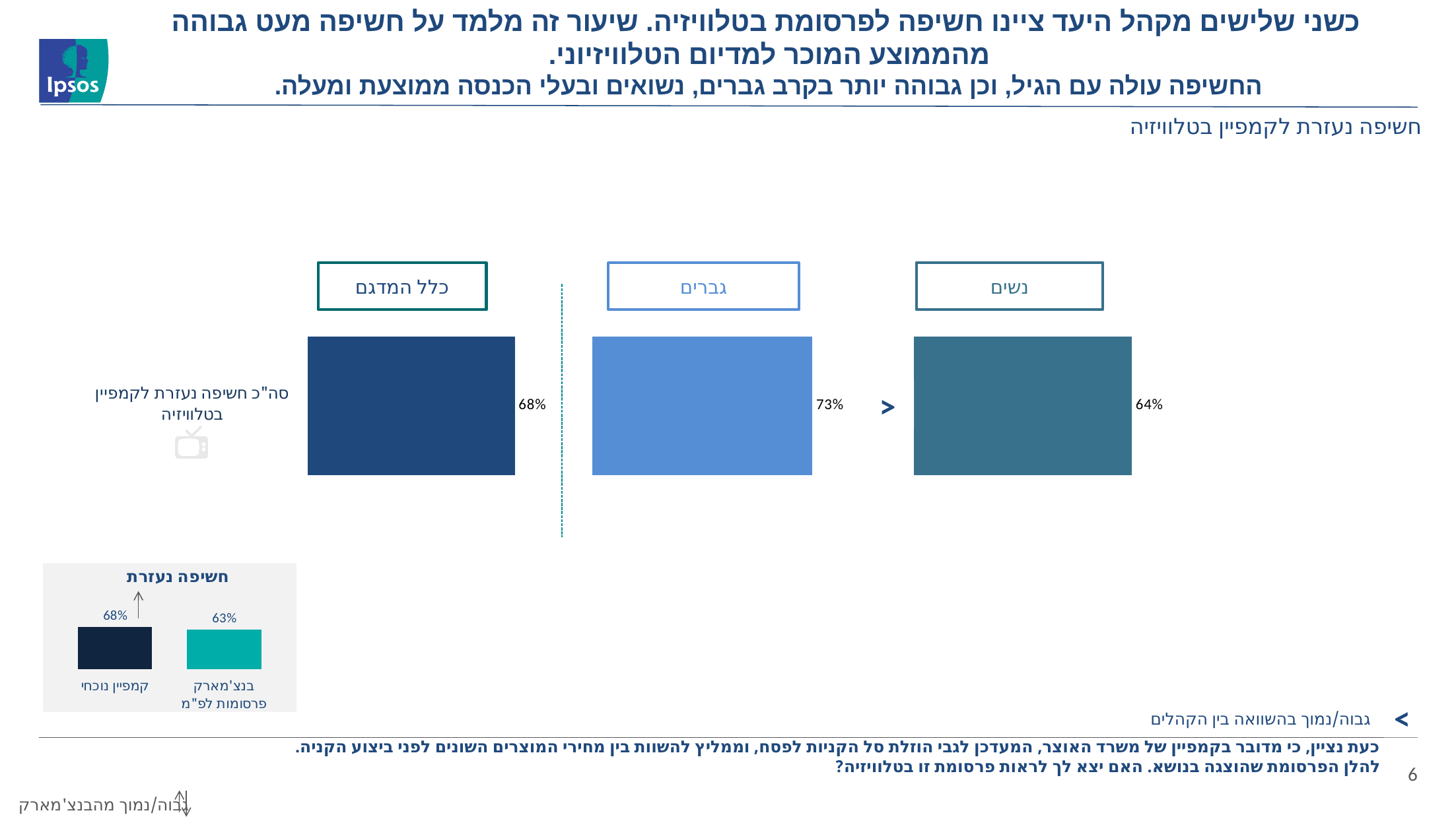
How many bars are shown in the main bar chart? 3 In the small chart at the bottom left (חשיפה נעזרת), what is the value for קמפיין נוכחי (current campaign)? 68% In the main bar chart, what is the value for כלל המדגם (total sample)? 68% In the small chart at the bottom left (חשיפה נעזרת), what is the value for בנצ'מארק פרסומות לפ"מ (benchmark)? 63% In the main bar chart, what is the value for נשים (women)? 64% In the main bar chart, what is the difference between the values for גברים and נשים? 9% In the main bar chart, which is larger: the value for גברים or the value for כלל המדגם? גברים In the small chart at the bottom left (חשיפה נעזרת), what is the difference between קמפיין נוכחי and the benchmark? 5% What kind of chart is the main chart on the slide? bar chart In the main bar chart, which group has the highest value? גברים In the main bar chart, which group has the lowest value? נשים In the main bar chart, what is the value for גברים (men)? 73%